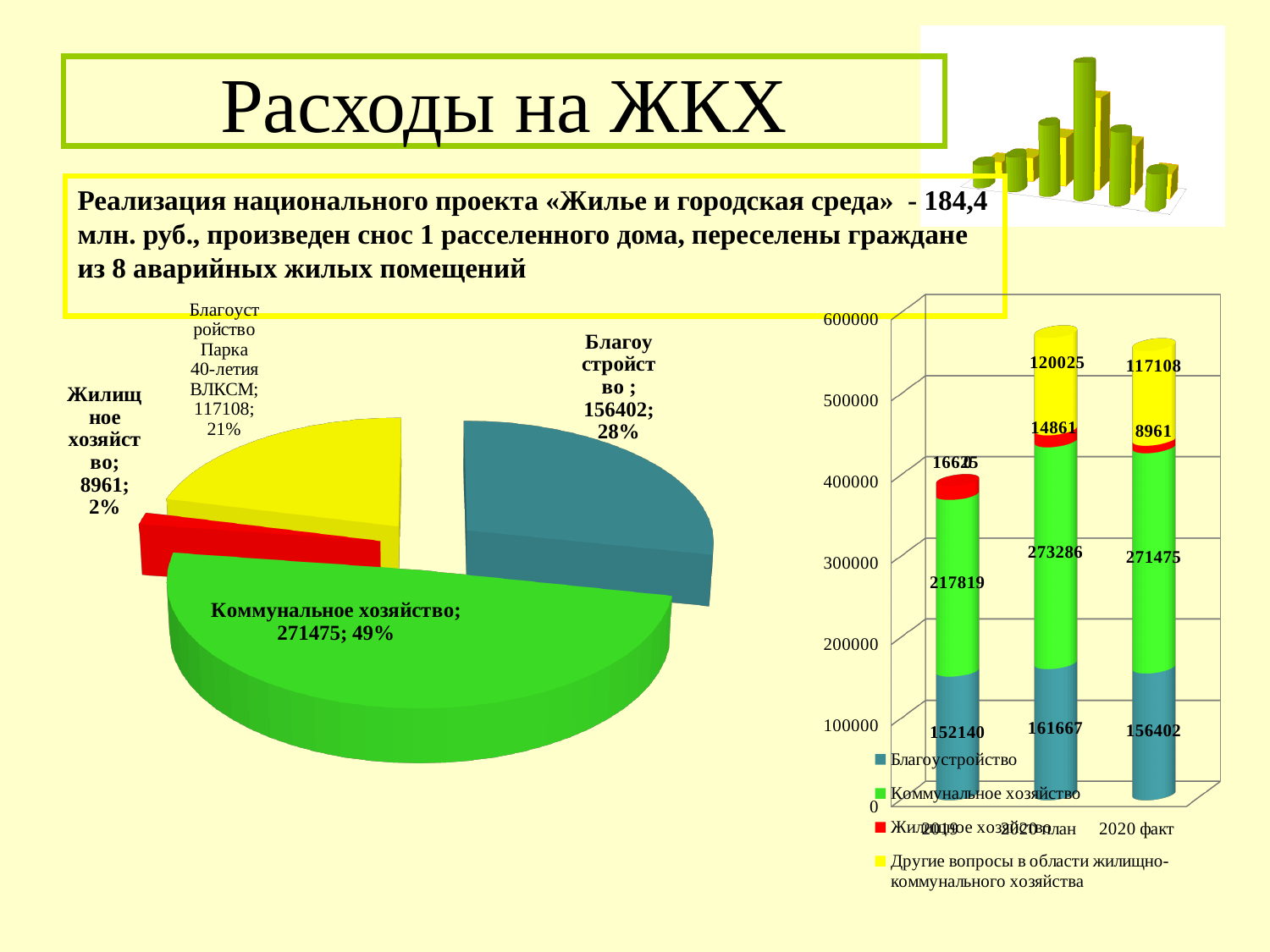
In the pie chart, which slice is the smallest? Жилищное хозяйство How many series does the legend of the bar chart list? 4 In the bar chart, what is the total of the stacked bar for 2020 факт? 553946 How many slices does the pie chart have? 4 In the bar chart, what is the difference between Благоустройство for 2020 план and for 2019? 9527 What kind of chart is the chart on the right of the slide? bar chart In the bar chart, what is the value of Коммунальное хозяйство for 2020 план? 273286 In the bar chart, is the value of Жилищное хозяйство for 2020 план larger or smaller than for 2020 факт? larger In the pie chart, which slice is the largest? Коммунальное хозяйство In the pie chart, what share does Благоустройство have? 28% In the pie chart, what value is shown for Коммунальное хозяйство? 271475 What kind of chart is the chart on the left of the slide? pie chart